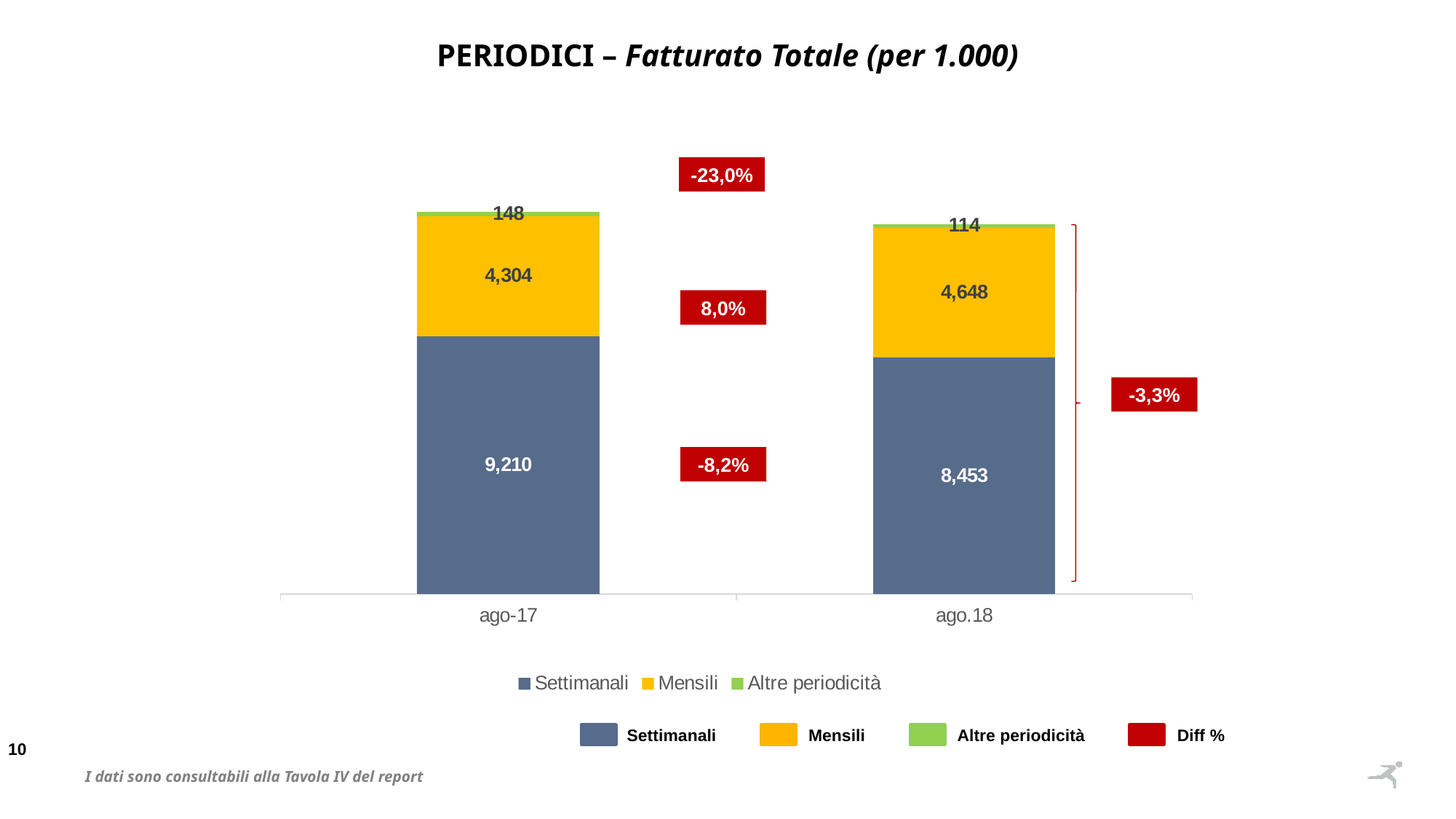
What is the value for Settimanali in ago-17? 9,210 Which is larger, Mensili in ago-17 or Mensili in ago.18? Mensili in ago.18 What is the total of the stacked bar for ago-17? 13,662 How many series does the chart legend list? 3 What is the title of the chart? PERIODICI – Fatturato Totale (per 1.000) What is the value for Settimanali in ago.18? 8,453 What is the percentage change shown for Altre periodicità between ago-17 and ago.18? -23,0% What is the difference between the Settimanali values for ago-17 and ago.18? 757 What is the total of the stacked bar for ago.18? 13,215 What is the value for Altre periodicità in ago-17? 148 What is the value for Mensili in ago.18? 4,648 What kind of chart is shown on the slide? Stacked bar chart